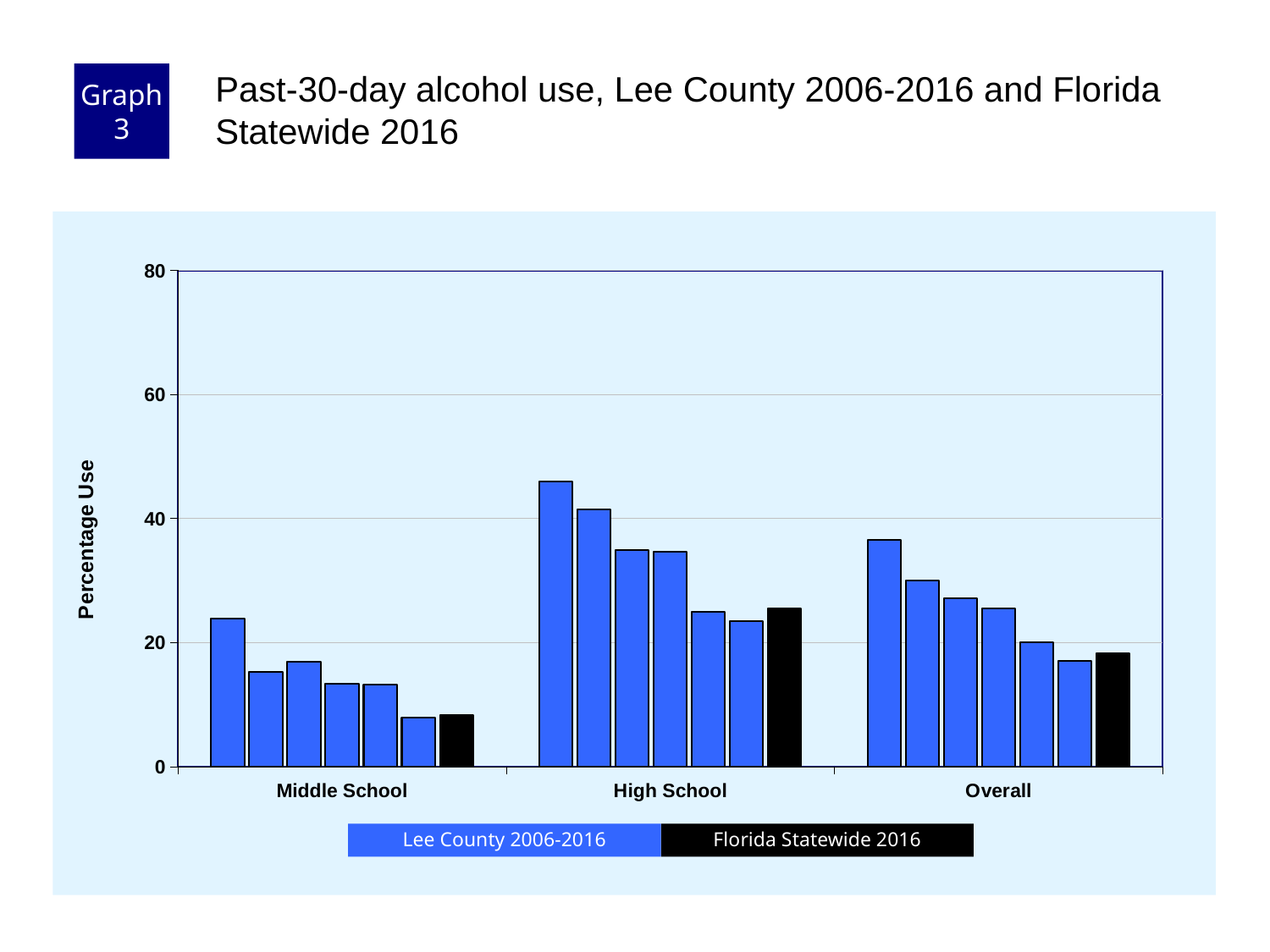
What is the label of the y axis? Percentage Use Is the value of the tallest Lee County bar in the High School group greater or less than 40? greater Which is larger, the Florida Statewide 2016 value for High School or for Middle School? High School How many series does the legend list? 2 Which category contains the highest bar in the chart? High School Is the value of the tallest Lee County bar in the Overall group greater or less than 40? less Is the value of the Florida Statewide 2016 bar for High School greater or less than 20? greater Within the High School group, do the Lee County 2006-2016 bars rise or fall from left to right? fall Which series is shown in black in the legend? Florida Statewide 2016 What kind of chart is shown on the slide? Bar chart How many categories are shown on the x axis? 3